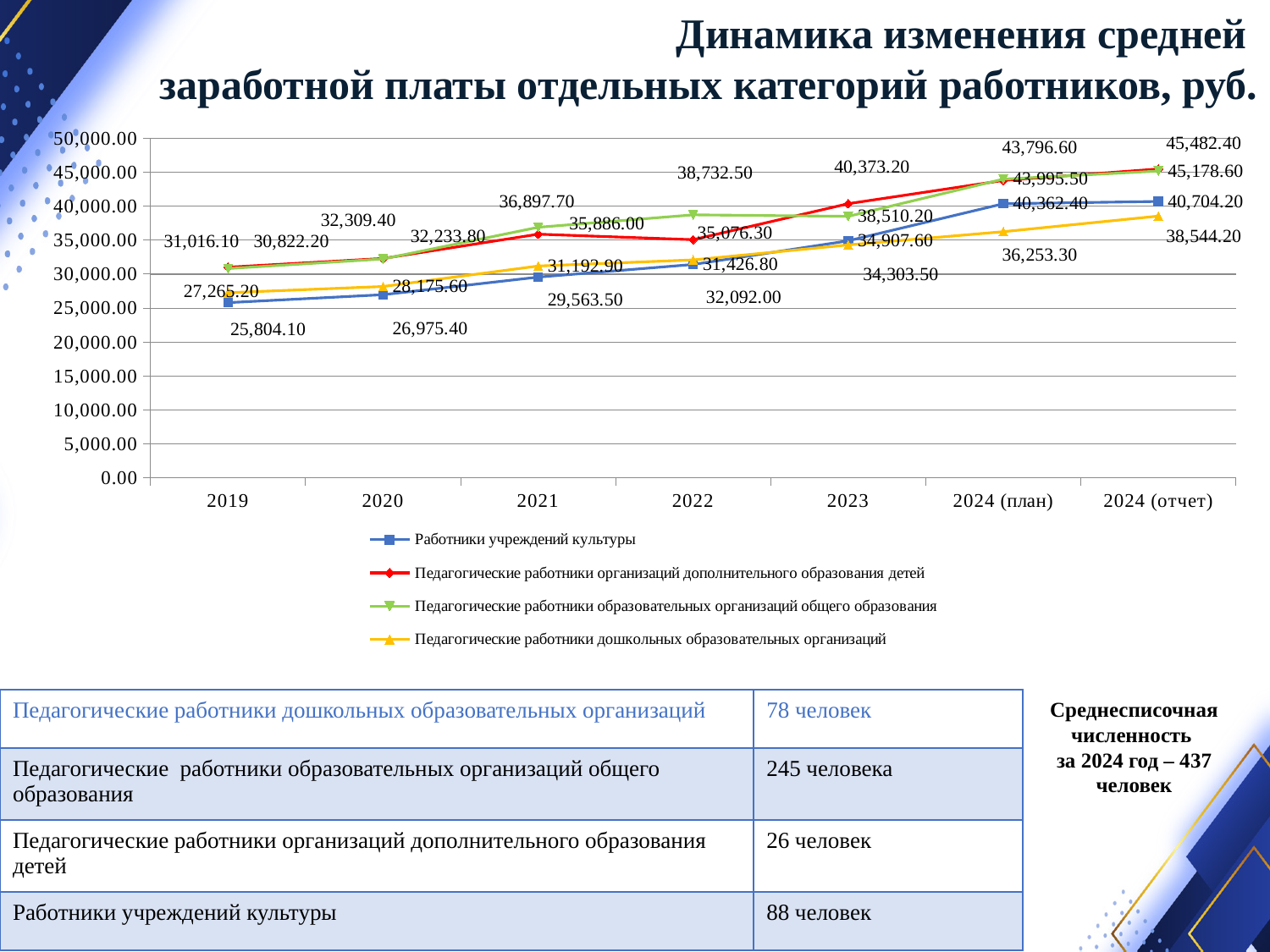
What is the value for Педагогические работники дошкольных образовательных организаций in 2024 (план)? 36,253.30 How many series does the chart legend list? 4 Do the values for Работники учреждений культуры rise or fall from 2019 to 2024 (отчет)? rise What is the value for Работники учреждений культуры in 2024 (отчет)? 40,704.20 How many points are plotted along the x axis of the chart? 7 Is the value for Педагогические работники дошкольных образовательных организаций in 2024 (отчет) greater or less than 40,000.00? less What is the value for Педагогические работники образовательных организаций общего образования in 2021? 36,897.70 Which series has the lowest value in 2019? Работники учреждений культуры In 2022, which is higher: Педагогические работники образовательных организаций общего образования or Педагогические работники организаций дополнительного образования детей? Педагогические работники образовательных организаций общего образования What is the value for Работники учреждений культуры in 2019? 25,804.10 By how much did the value for Работники учреждений культуры increase from 2019 to 2024 (отчет)? 14,900.10 What kind of chart is shown on the slide? line chart